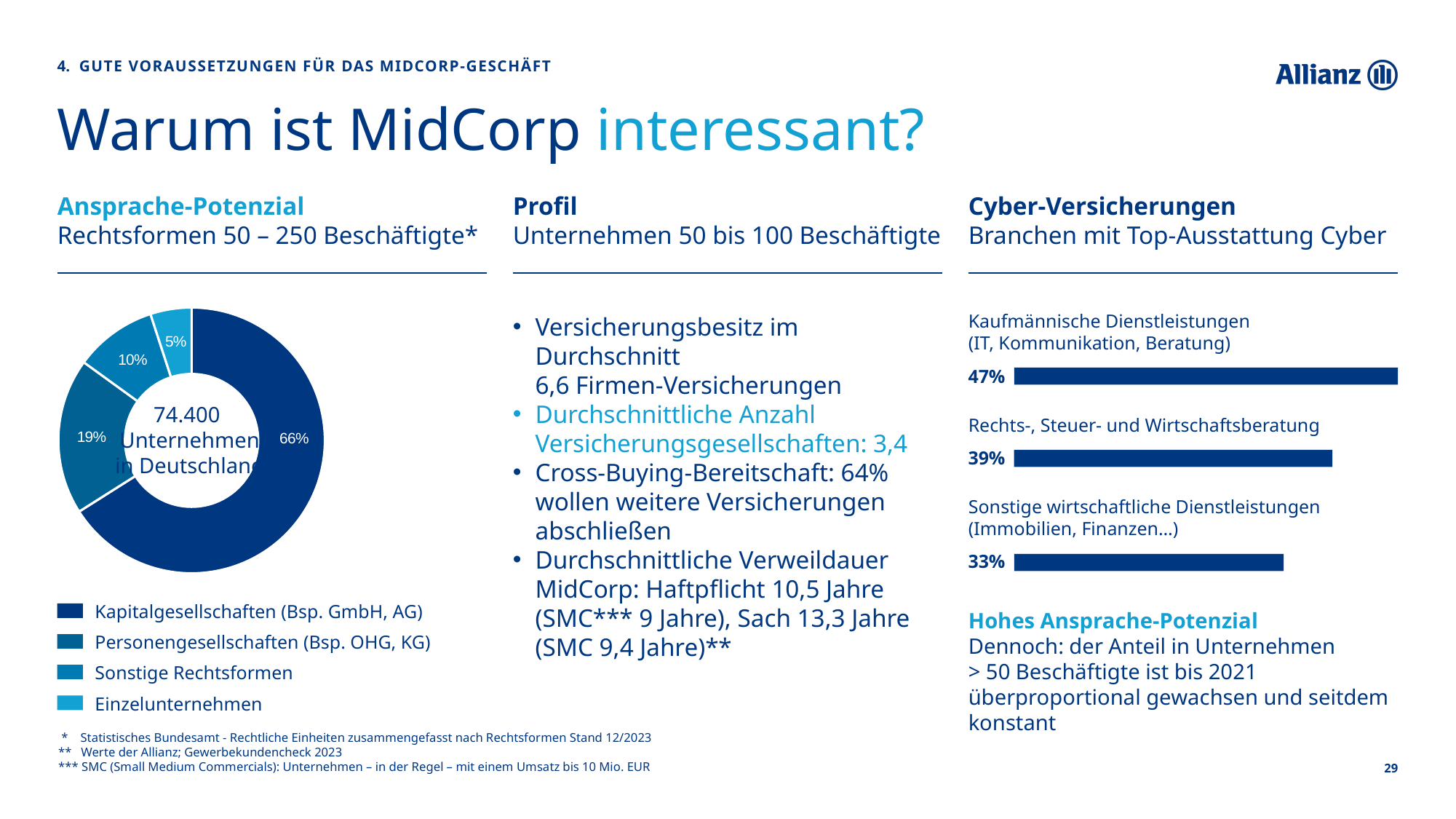
In the donut chart on the left, what share do Einzelunternehmen have? 5% In the donut chart on the left, what share do Kapitalgesellschaften (Bsp. GmbH, AG) have? 66% In the donut chart on the left, which legal form has the largest share? Kapitalgesellschaften (Bsp. GmbH, AG) What type of chart is shown under 'Ansprache-Potenzial' on the left? Donut (pie) chart In the bar chart under 'Cyber-Versicherungen' on the right, which sector has the highest value? Kaufmännische Dienstleistungen (IT, Kommunikation, Beratung) What number of companies is written in the centre of the donut chart on the left? 74.400 Unternehmen in Deutschland In the donut chart on the left, how many categories does the legend list? 4 In the bar chart under 'Cyber-Versicherungen' on the right, what is the difference between Kaufmännische Dienstleistungen and Sonstige wirtschaftliche Dienstleistungen? 14 percentage points In the donut chart on the left, what share do Personengesellschaften (Bsp. OHG, KG) have? 19% In the donut chart on the left, which legal form has the smallest share? Einzelunternehmen In the bar chart under 'Cyber-Versicherungen' on the right, what is the value for Rechts-, Steuer- und Wirtschaftsberatung? 39% In the donut chart on the left, how many percentage points larger is the share of Personengesellschaften than the share of Sonstige Rechtsformen? 9 percentage points